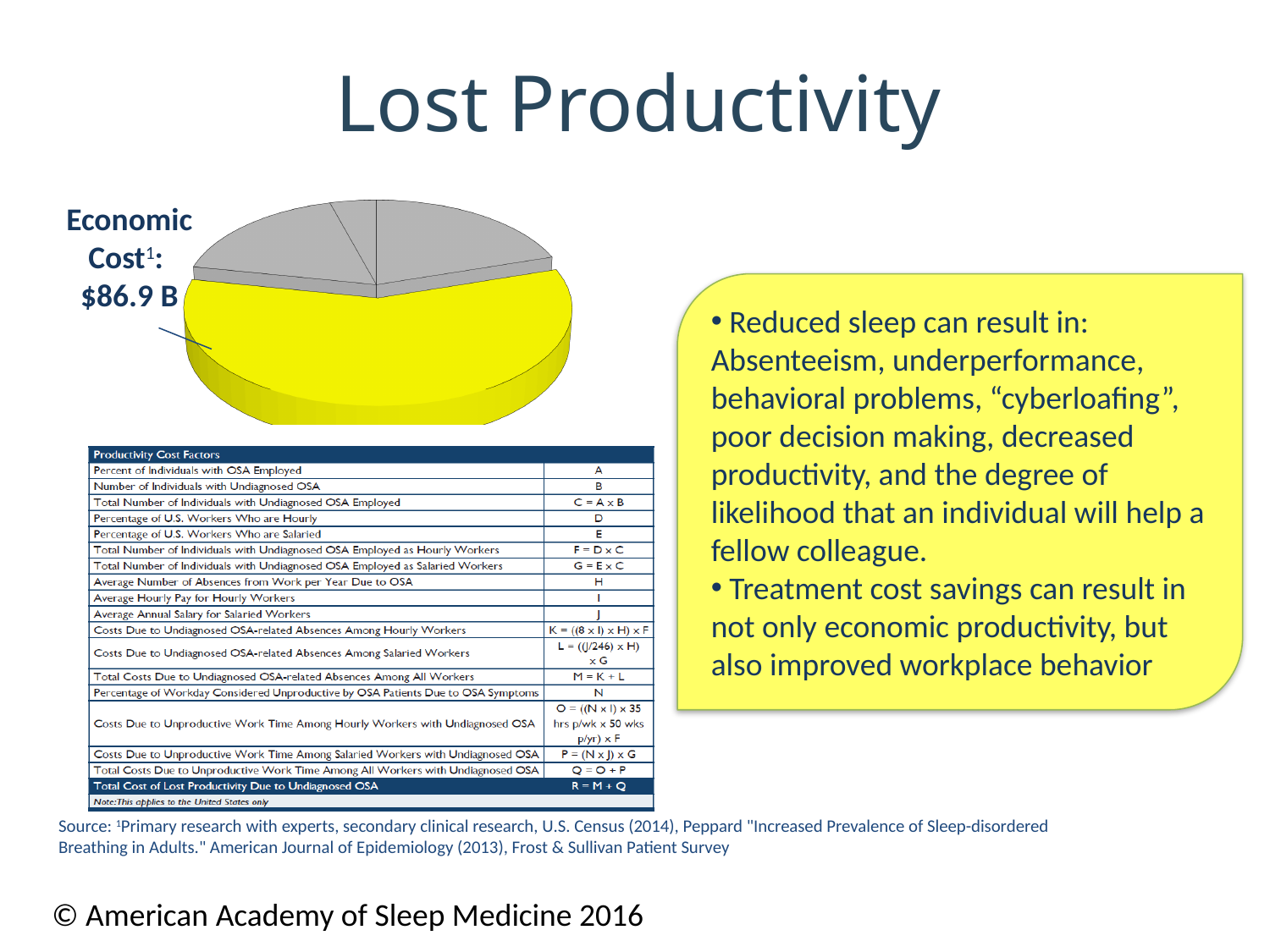
How many slices does the pie chart have? 4 What colour is the Economic Cost slice in the pie chart? yellow What kind of chart is shown on the slide? pie chart Which slice of the pie chart is the largest? Economic Cost (the yellow slice) How many slices of the pie chart are labeled with a value? 1 Does the Economic Cost slice represent more or less than half of the pie? more What value is given for the Economic Cost slice of the pie chart? $86.9 B